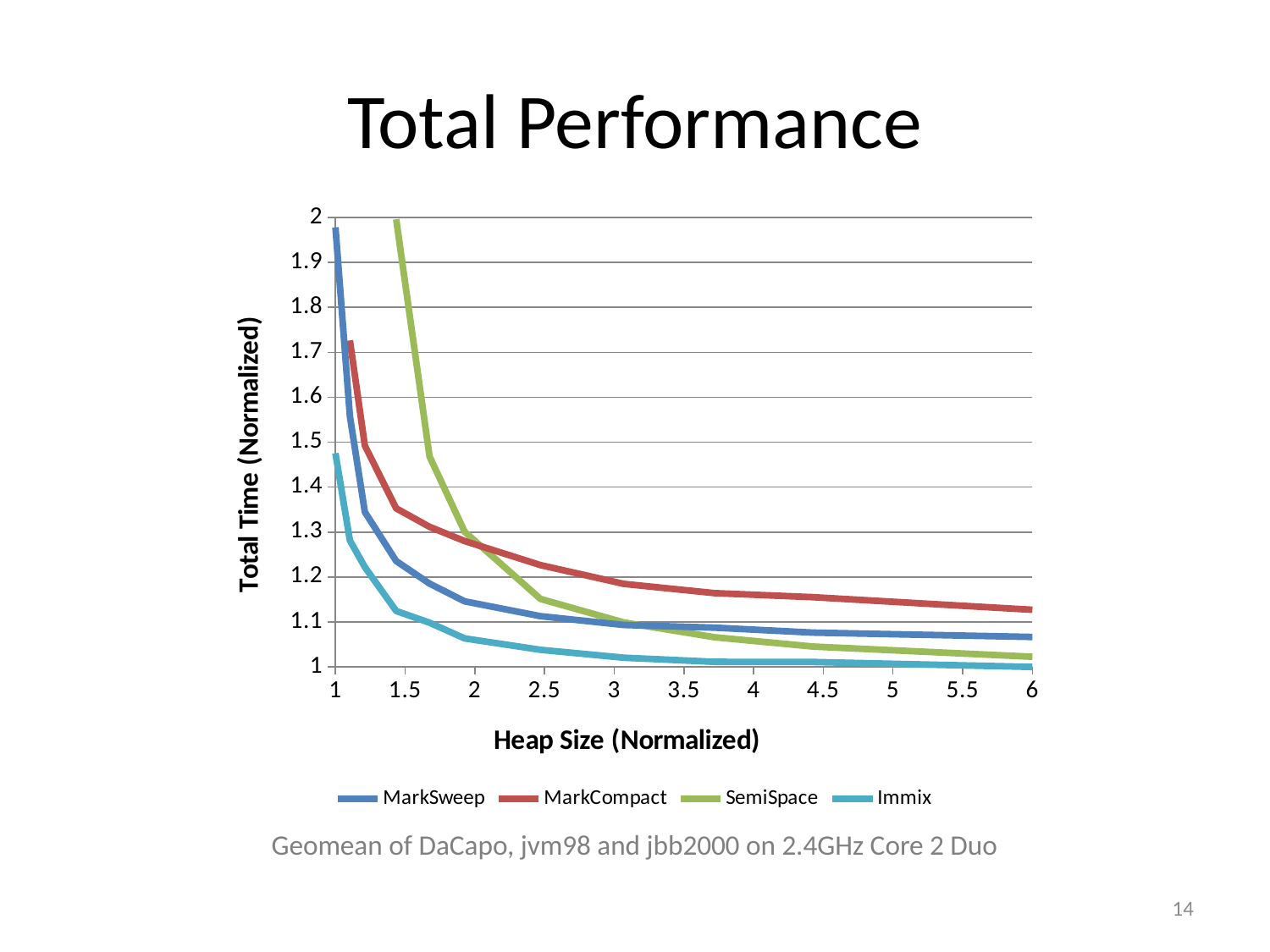
Do the total time values rise or fall as heap size increases? fall What kind of chart is shown on the slide? line chart What is the label of the x axis? Heap Size (Normalized) Which series has the lowest value at heap size 6? Immix At heap size 2, which is higher, SemiSpace or MarkSweep? SemiSpace Is the value for MarkSweep at heap size 1 greater or less than 1.9? greater What is the title of the chart? Total Performance Is the value for Immix at heap size 1 greater or less than 1.4? greater Is the value for SemiSpace at heap size 6 greater or less than 1.1? less Which series has the highest value at heap size 6? MarkCompact How many series does the legend list? 4 At heap size 6, which is higher, MarkCompact or Immix? MarkCompact